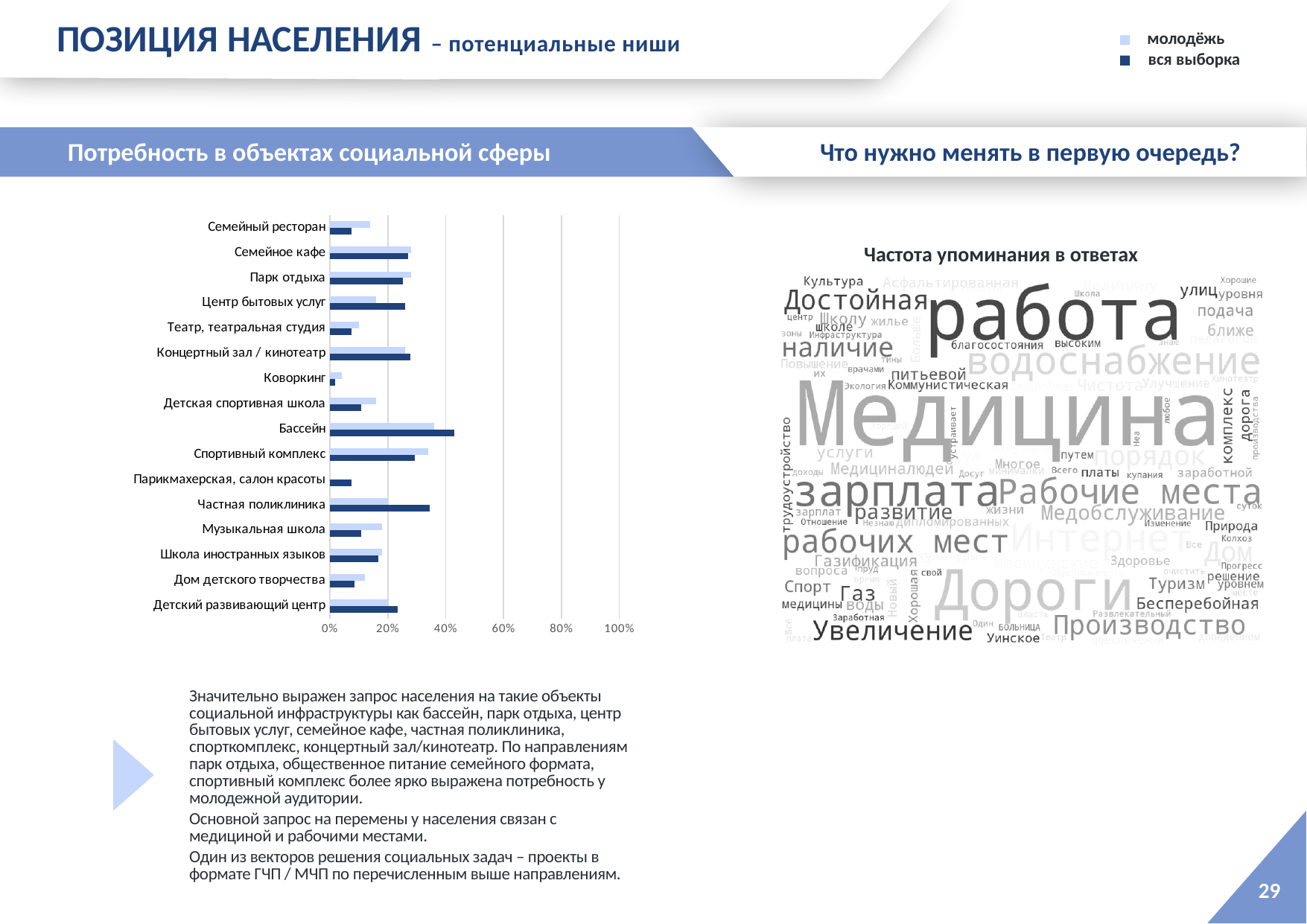
In the 'Потребность в объектах социальной сферы' chart, is the 'вся выборка' value for Коворкинг greater or less than 20%? less In the 'Потребность в объектах социальной сферы' chart, is the 'вся выборка' value for Бассейн greater or less than 20%? greater In the 'Потребность в объектах социальной сферы' chart, is the 'вся выборка' value for Частная поликлиника greater or less than 20%? greater In the 'Потребность в объектах социальной сферы' chart, which series is shown in dark blue according to the legend? вся выборка In the 'Потребность в объектах социальной сферы' chart, which is larger for Частная поликлиника: the 'молодёжь' value or the 'вся выборка' value? вся выборка How many series does the legend list for the 'Потребность в объектах социальной сферы' chart? 2 In the 'Потребность в объектах социальной сферы' chart, which category has the highest value for 'вся выборка'? Бассейн In the 'Потребность в объектах социальной сферы' chart, which is larger for 'вся выборка': Бассейн or Коворкинг? Бассейн How many categories are shown in the 'Потребность в объектах социальной сферы' bar chart? 16 What kind of chart is used in the 'Потребность в объектах социальной сферы' section? bar chart In the 'Потребность в объектах социальной сферы' chart, which category has the lowest value for 'вся выборка'? Коворкинг